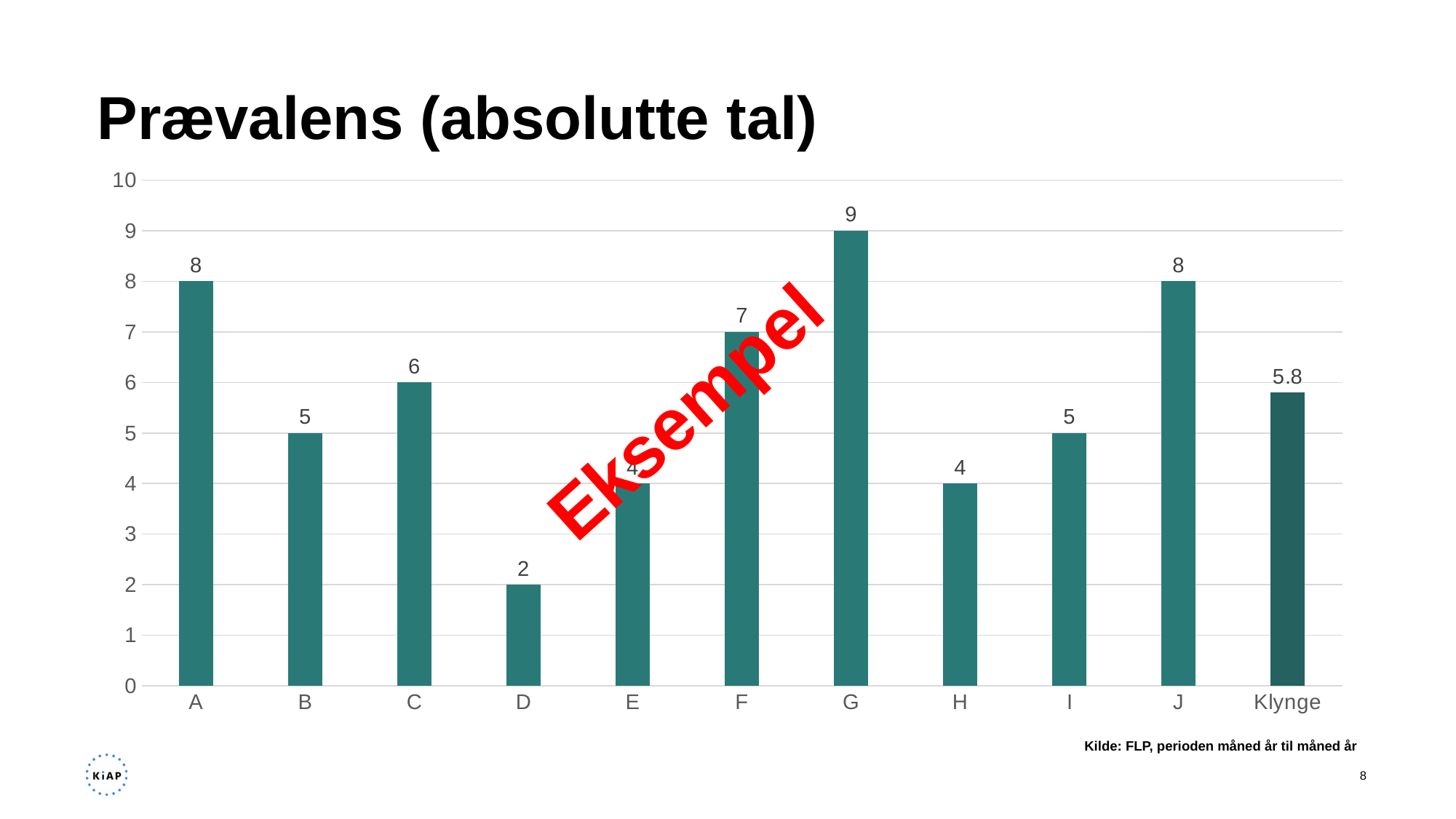
What is the title of the chart? Prævalens (absolutte tal) What is the value for category G? 9 Which category has the highest value? G What is the difference between the values for G and D? 7 What kind of chart is shown on the slide? bar chart Is the value for F greater or less than 5? greater What is the value for category D? 2 Which category has the lowest value? D What is the value for Klynge? 5.8 Which is larger, the value for C or the value for H? C What is the difference between the values for A and B? 3 How many categories are shown on the x axis? 11